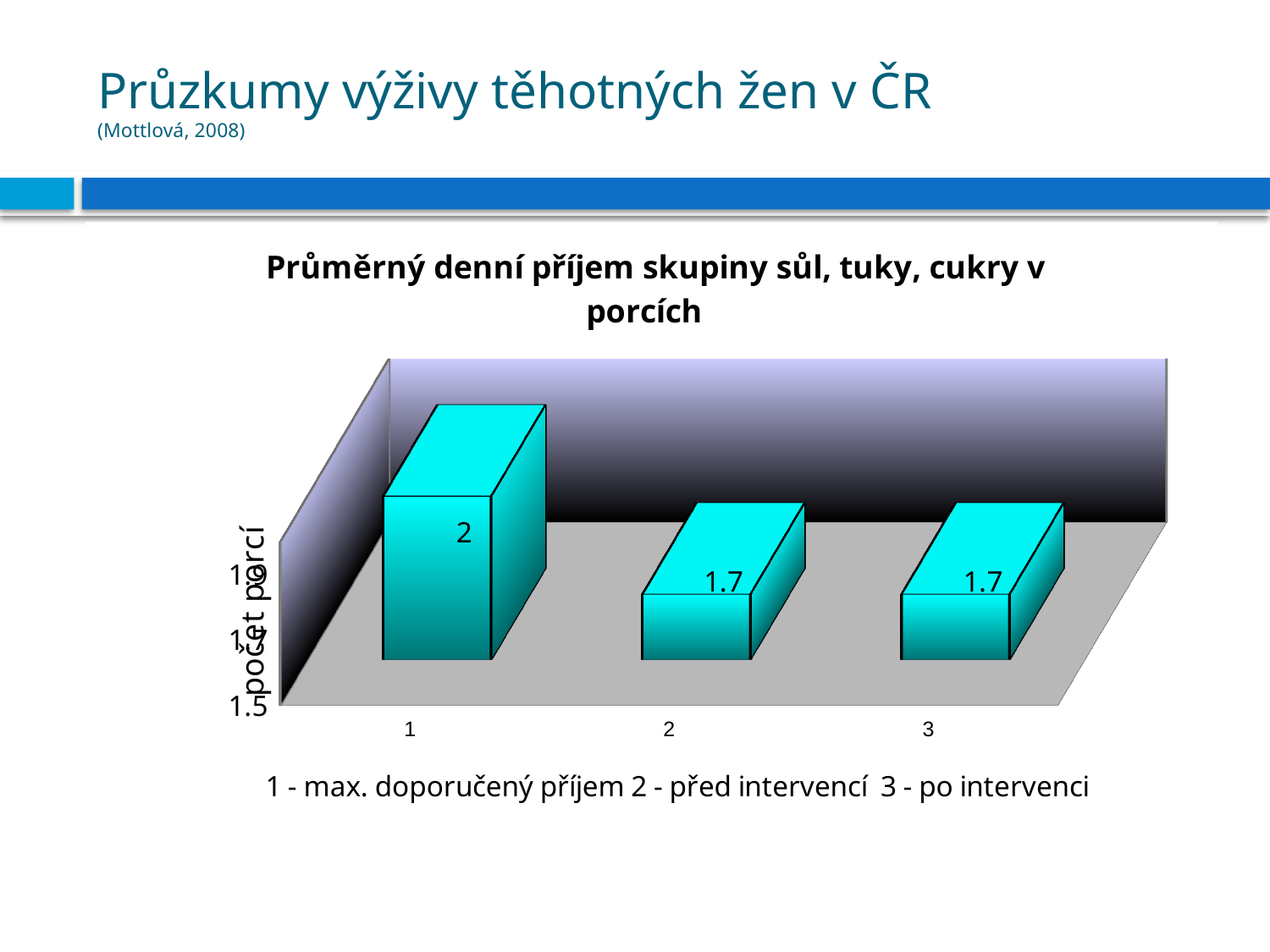
Which category has the highest value in the chart? 1 Which is larger, the value for category 1 or the value for category 3? category 1 Do the values rise or fall from category 1 to category 2? fall What is the title of the chart? Průměrný denní příjem skupiny sůl, tuky, cukry v porcích What is the value for category 1 in the chart? 2 How many categories are plotted in the chart? 3 What is the value for category 3 in the chart? 1.7 What kind of chart is shown on the slide? bar chart According to the note below the chart, what does category 3 represent? po intervenci What is the value for category 2 in the chart? 1.7 What is the difference between the value for category 1 and the value for category 2? 0.3 Is the value for category 2 greater or less than 1.5? greater